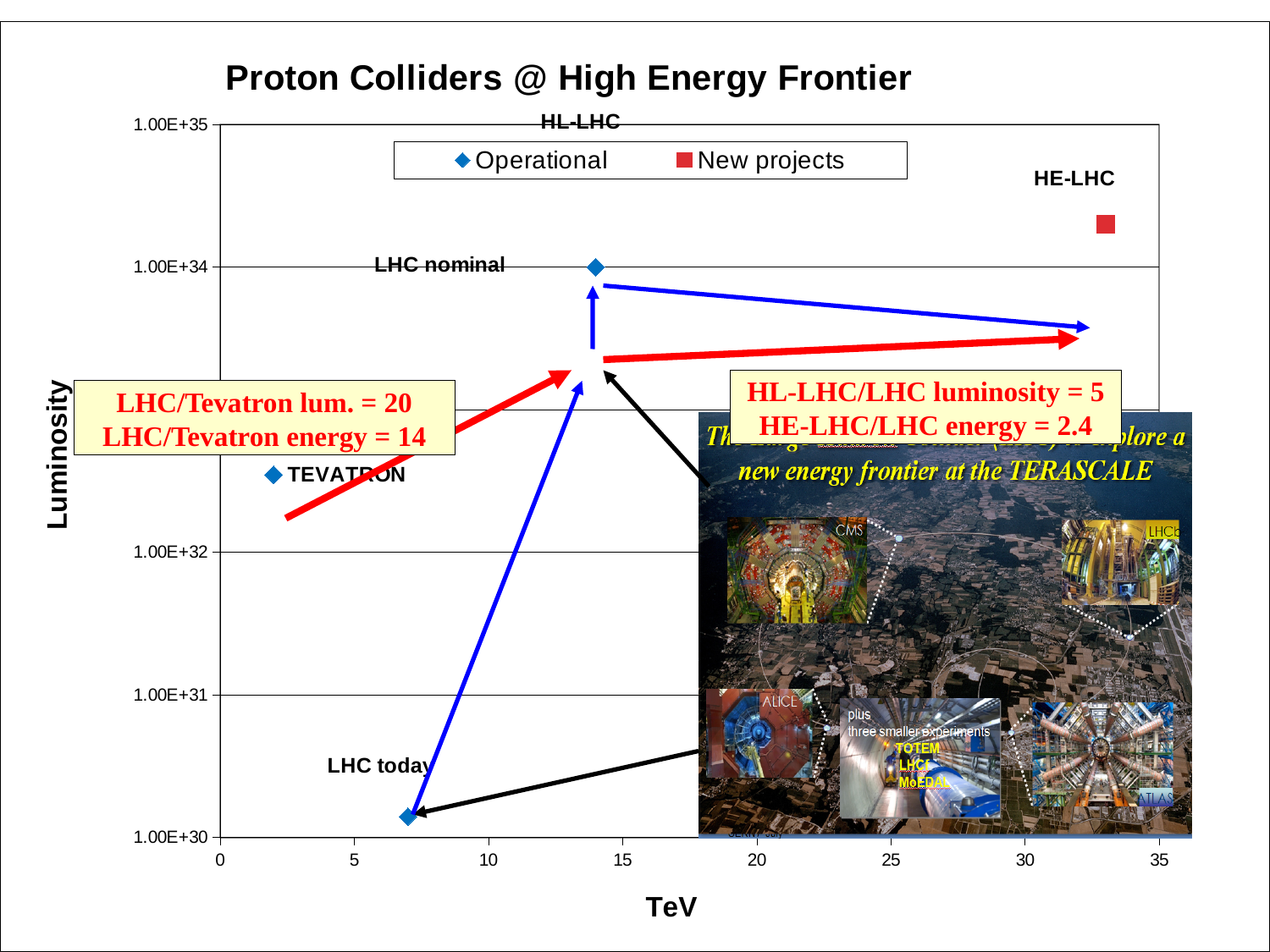
What is the label of the x axis of the chart? TeV What is the luminosity value plotted for LHC nominal? 1.00E+34 Which collider has the highest energy (TeV) on the chart? HE-LHC Is the energy for HE-LHC greater or less than 30 TeV? greater Is the luminosity for LHC today greater or less than 1.00E+31? less Which has the higher luminosity, HE-LHC or LHC nominal? HE-LHC How many series does the chart legend list? 2 Which has the higher luminosity, TEVATRON or LHC today? TEVATRON Is the luminosity for TEVATRON greater or less than 1.00E+33? less Which collider has the lowest energy (TeV) on the chart? TEVATRON What type of chart is shown on the slide? scatter chart Which collider has the lowest luminosity on the chart? LHC today